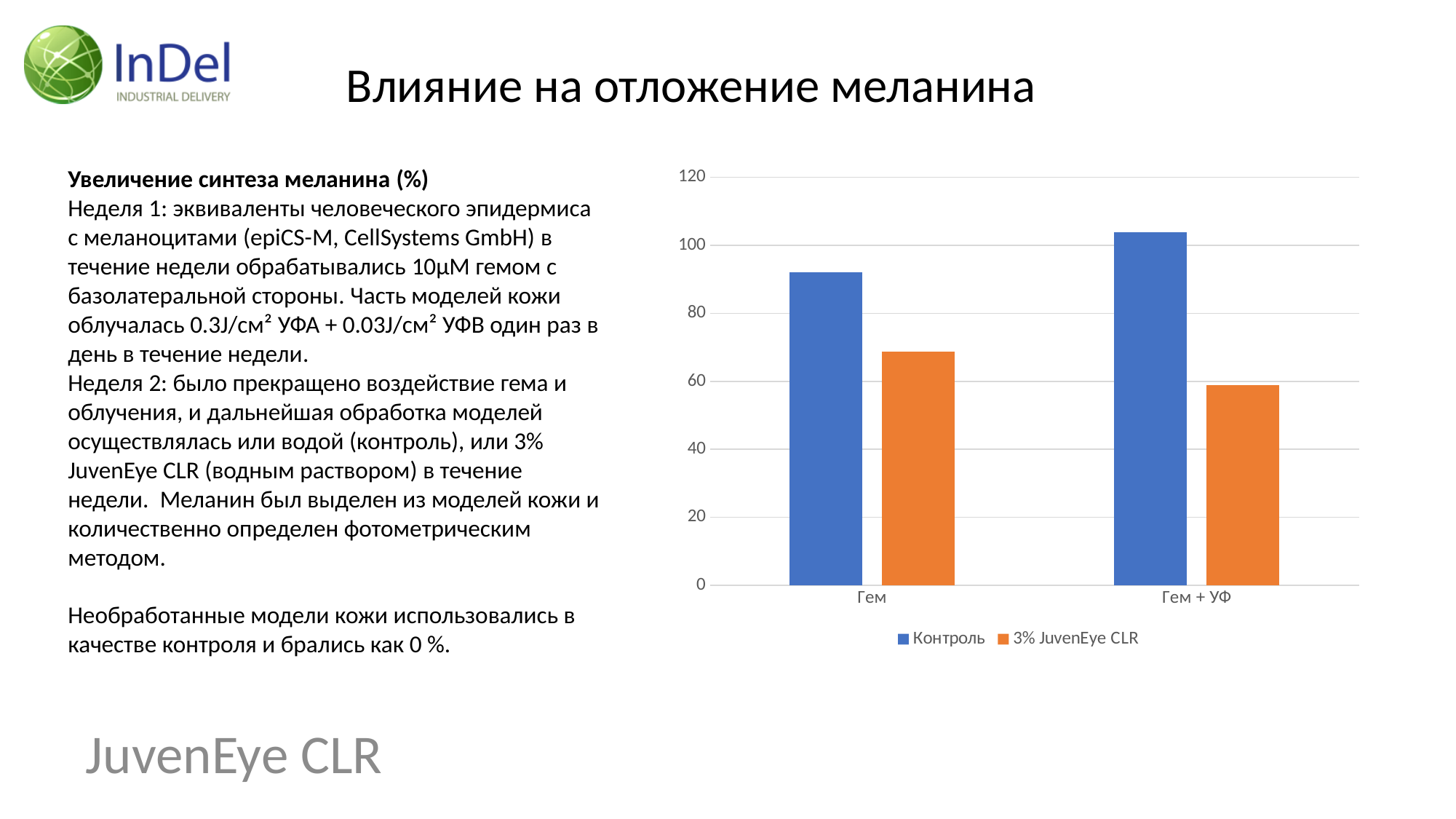
Is the value for Контроль in the Гем + УФ category greater or less than 100? greater How many categories are shown on the x axis of the chart? 2 Which bar in the chart is the highest? Контроль in Гем + УФ How many series does the chart legend list? 2 Which bar in the chart is the lowest? 3% JuvenEye CLR in Гем + УФ Is the value for 3% JuvenEye CLR in the Гем category greater or less than 60? greater Which series is shown in blue in the chart? Контроль Is the value for Контроль in the Гем category greater or less than 80? greater What kind of chart is shown on the slide? bar chart In the Гем + УФ category, which series has the larger value, Контроль or 3% JuvenEye CLR? Контроль Which series is shown in orange in the chart? 3% JuvenEye CLR